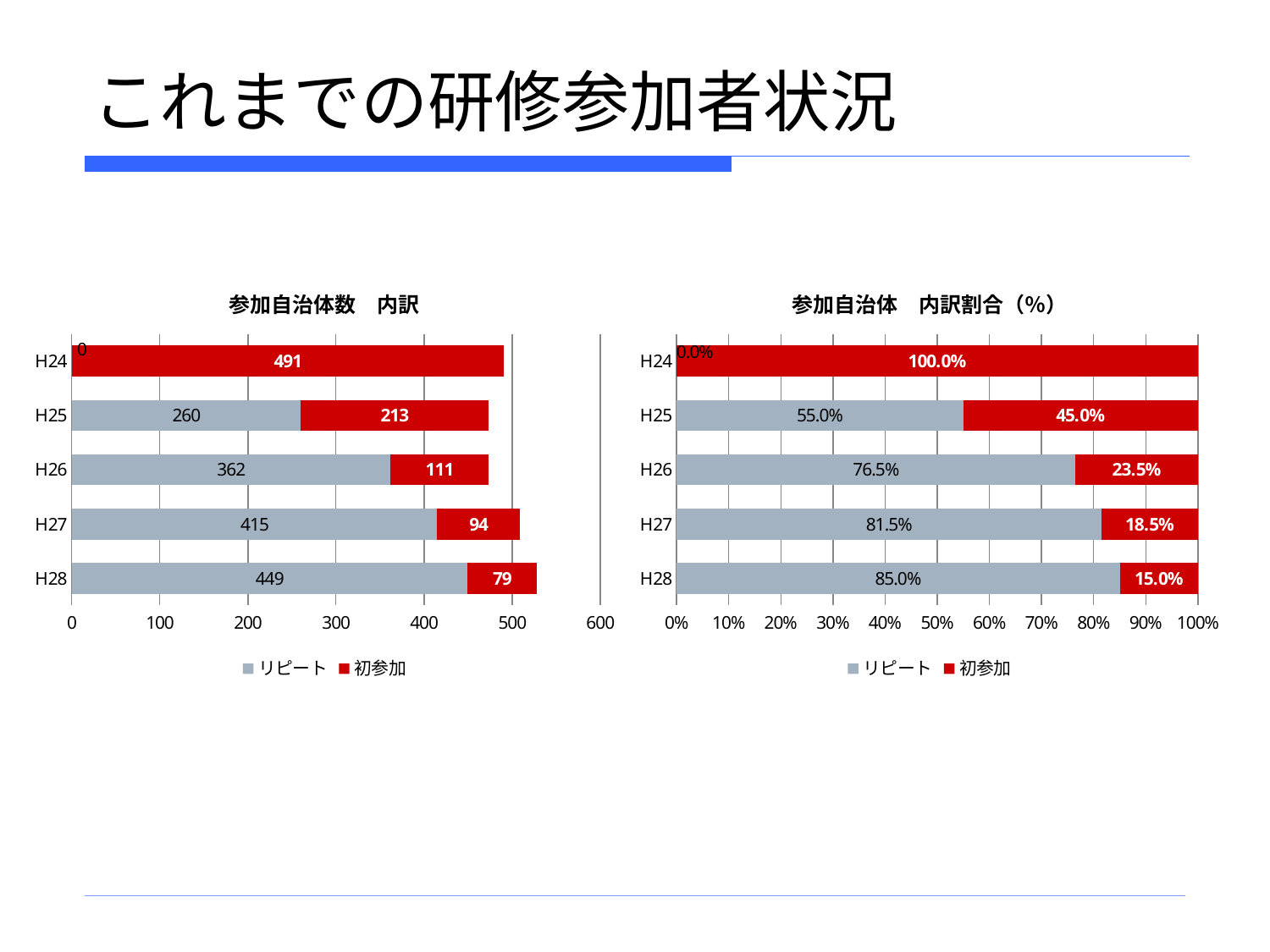
In the left chart (参加自治体数 内訳), what is the total of the stacked bar for H28? 528 In the right chart (参加自治体 内訳割合), is the リピート share larger for H25 or H28? H28 In the left chart (参加自治体数 内訳), which year has the lowest 初参加 value? H28 In the left chart (参加自治体数 内訳), what is the 初参加 value for H25? 213 In the left chart (参加自治体数 内訳), which year has the highest 初参加 value? H24 In the left chart (参加自治体数 内訳), what is the difference between the リピート values for H28 and H26? 87 In the right chart (参加自治体 内訳割合), what is the リピート share for H26? 76.5% In the left chart (参加自治体数 内訳), what is the リピート value for H27? 415 In the right chart (参加自治体 内訳割合), does the 初参加 share rise or fall from H24 to H28? fall In the left chart (参加自治体数 内訳), how many years are shown on the y axis? 5 How many series does the legend of the left chart (参加自治体数 内訳) list? 2 In the right chart (参加自治体 内訳割合), what is the 初参加 share for H27? 18.5%